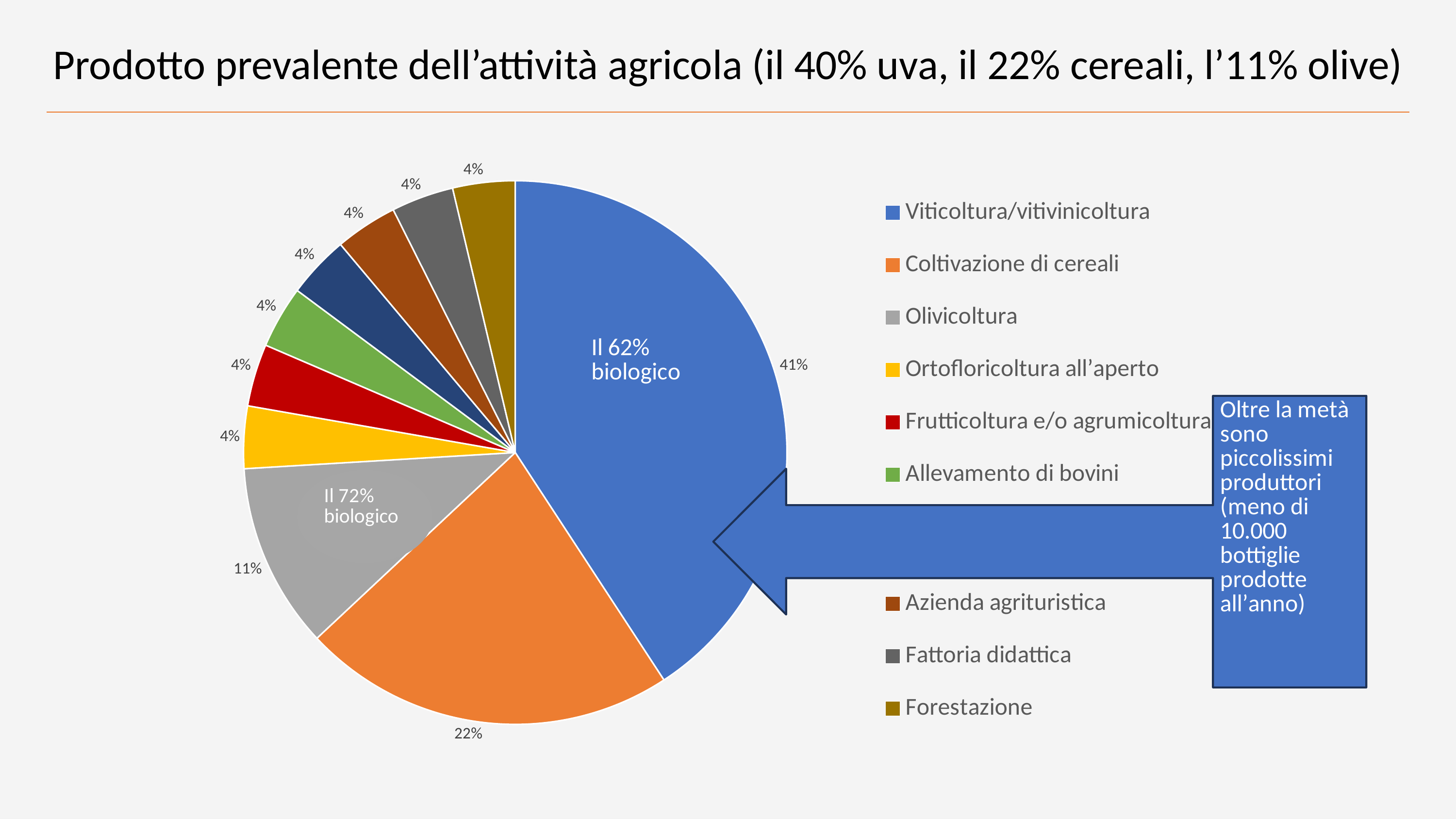
What percentage is labelled for the Olivicoltura slice? 11% What is the difference between the Coltivazione di cereali slice and the Olivicoltura slice? 11 percentage points What percentage of the pie chart does Viticoltura/vitivinicoltura represent? 41% How many slices does the pie chart have? 10 What type of chart is shown on the slide? Pie chart What text is written inside the blue Viticoltura/vitivinicoltura slice? Il 62% biologico What is the value of the Forestazione slice? 4% What is the value shown for Coltivazione di cereali in the pie chart? 22% By how many percentage points does Viticoltura/vitivinicoltura exceed Coltivazione di cereali? 19 percentage points Which category has the largest slice in the pie chart? Viticoltura/vitivinicoltura What is the value of the Fattoria didattica slice? 4% Which is larger, the Olivicoltura slice or the Coltivazione di cereali slice? Coltivazione di cereali